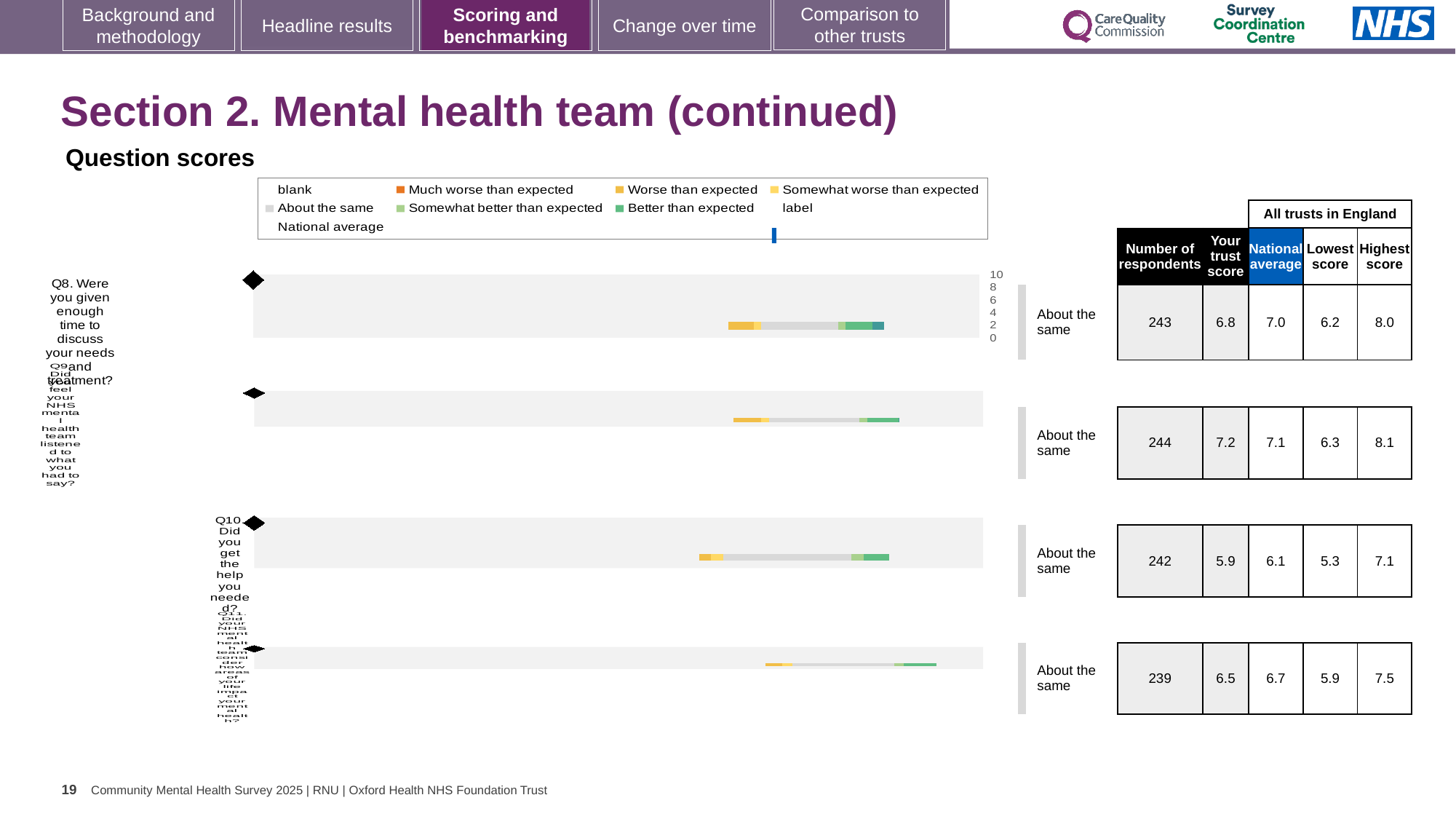
What kind of chart is used to show the question scores on this slide? bar chart What is the lowest score among all trusts in England for Q9? 6.3 What benchmark category is shown next to the bar for Q8? About the same What is the highest score among all trusts in England for Q11? 7.5 What is the 'Your trust score' value for Q8 (Were you given enough time to discuss your needs and treatment?)? 6.8 How many respondents answered Q10 (Did you get the help you needed?)? 242 Which question has the highest 'Your trust score'? Q9 For Q8, what is the difference between the highest score and the lowest score across all trusts in England? 1.8 Which question has the lowest 'Your trust score'? Q10 What is the national average score for Q9? 7.1 For Q11, which is larger: the trust score or the national average? National average How many questions (rows) are plotted in the question scores chart? 4